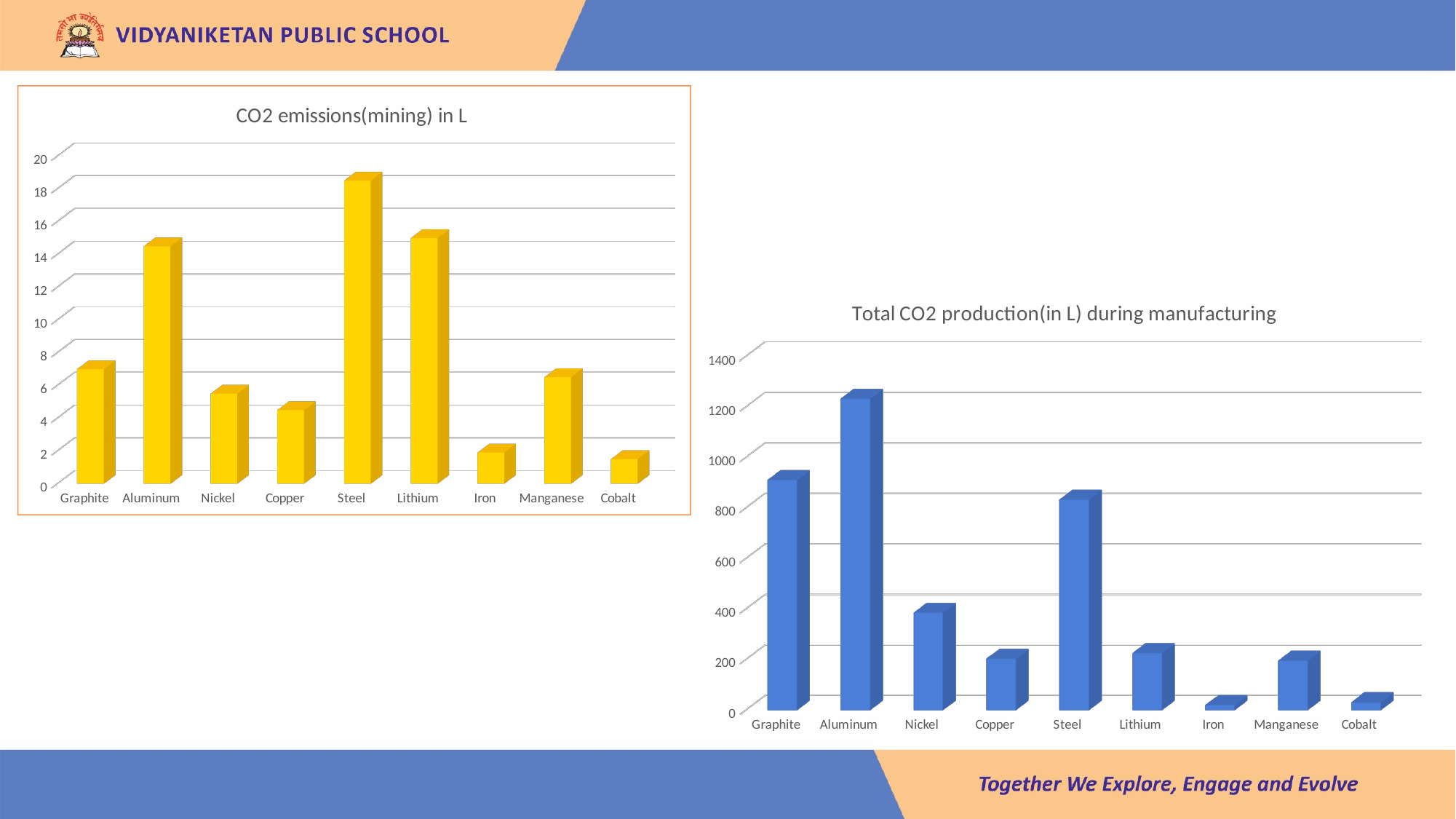
In the 'Total CO2 production(in L) during manufacturing' chart, which is larger, the value for Aluminum or the value for Graphite? Aluminum In the 'CO2 emissions(mining) in L' chart, which category has the highest value? Steel In the 'CO2 emissions(mining) in L' chart, which is larger, the value for Steel or the value for Lithium? Steel In the 'Total CO2 production(in L) during manufacturing' chart, is the value for Copper greater or less than 400? less What kind of chart is the 'Total CO2 production(in L) during manufacturing' chart? bar chart In the 'CO2 emissions(mining) in L' chart, is the value for Iron greater or less than 4? less In the 'Total CO2 production(in L) during manufacturing' chart, which category has the highest value? Aluminum In the 'CO2 emissions(mining) in L' chart, is the value for Steel greater or less than 16? greater How many categories are shown on the x axis of the 'CO2 emissions(mining) in L' chart? 9